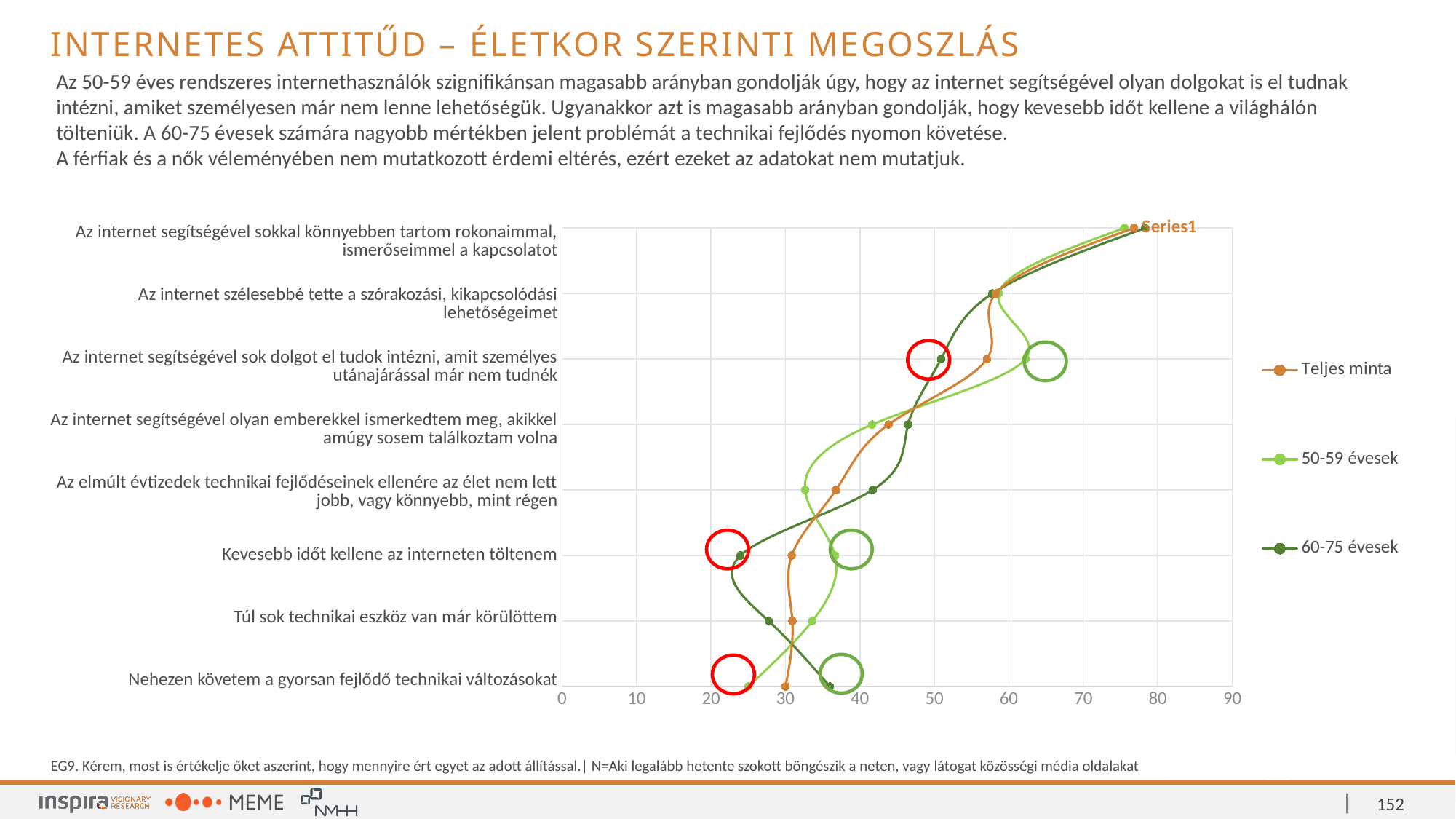
What is the highest value shown on the horizontal axis of the chart? 90 How many statements (categories) are plotted on the chart? 8 Is the value of the Teljes minta series for "Az internet segítségével sokkal könnyebben tartom rokonaimmal, ismerőseimmel a kapcsolatot" greater or less than 70? greater Is the value of the 60-75 évesek series for "Kevesebb időt kellene az interneten töltenem" greater or less than 30? less Is the value of the 50-59 évesek series for "Kevesebb időt kellene az interneten töltenem" greater or less than 30? greater For "Az internet segítségével sok dolgot el tudok intézni, amit személyes utánajárással már nem tudnék", which series has the highest value? 50-59 évesek How many series does the chart legend list? 3 For "Az elmúlt évtizedek technikai fejlődéseinek ellenére az élet nem lett jobb, vagy könnyebb, mint régen", which is larger: the 60-75 évesek value or the 50-59 évesek value? 60-75 évesek For "Nehezen követem a gyorsan fejlődő technikai változásokat", which is larger: the 60-75 évesek value or the 50-59 évesek value? 60-75 évesek Which series are listed in the chart legend? Teljes minta, 50-59 évesek, 60-75 évesek What kind of chart is shown on the slide? line chart